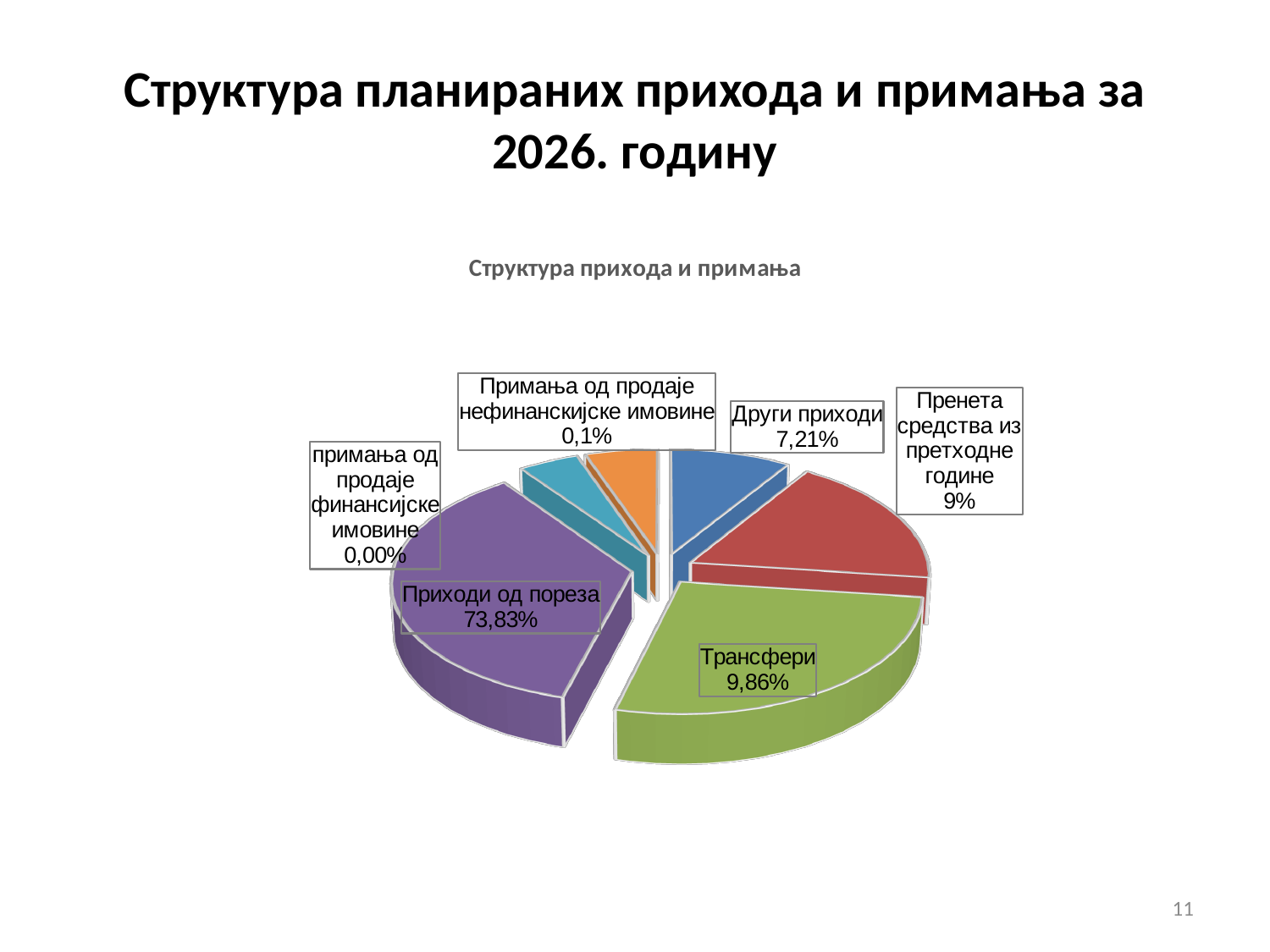
What share of the pie does Приходи од пореза have? 73,83% What is the title of the chart? Структура прихода и примања How many slices does the pie chart have? 6 Which category has the largest share of the pie? Приходи од пореза Which category has the smallest share of the pie? примања од продаје финансијске имовине What kind of chart is shown on the slide? pie chart Which is larger, the share for Трансфери or the share for Други приходи? Трансфери What share of the pie does Трансфери have? 9,86% What share of the pie does примања од продаје финансијске имовине have? 0,00%